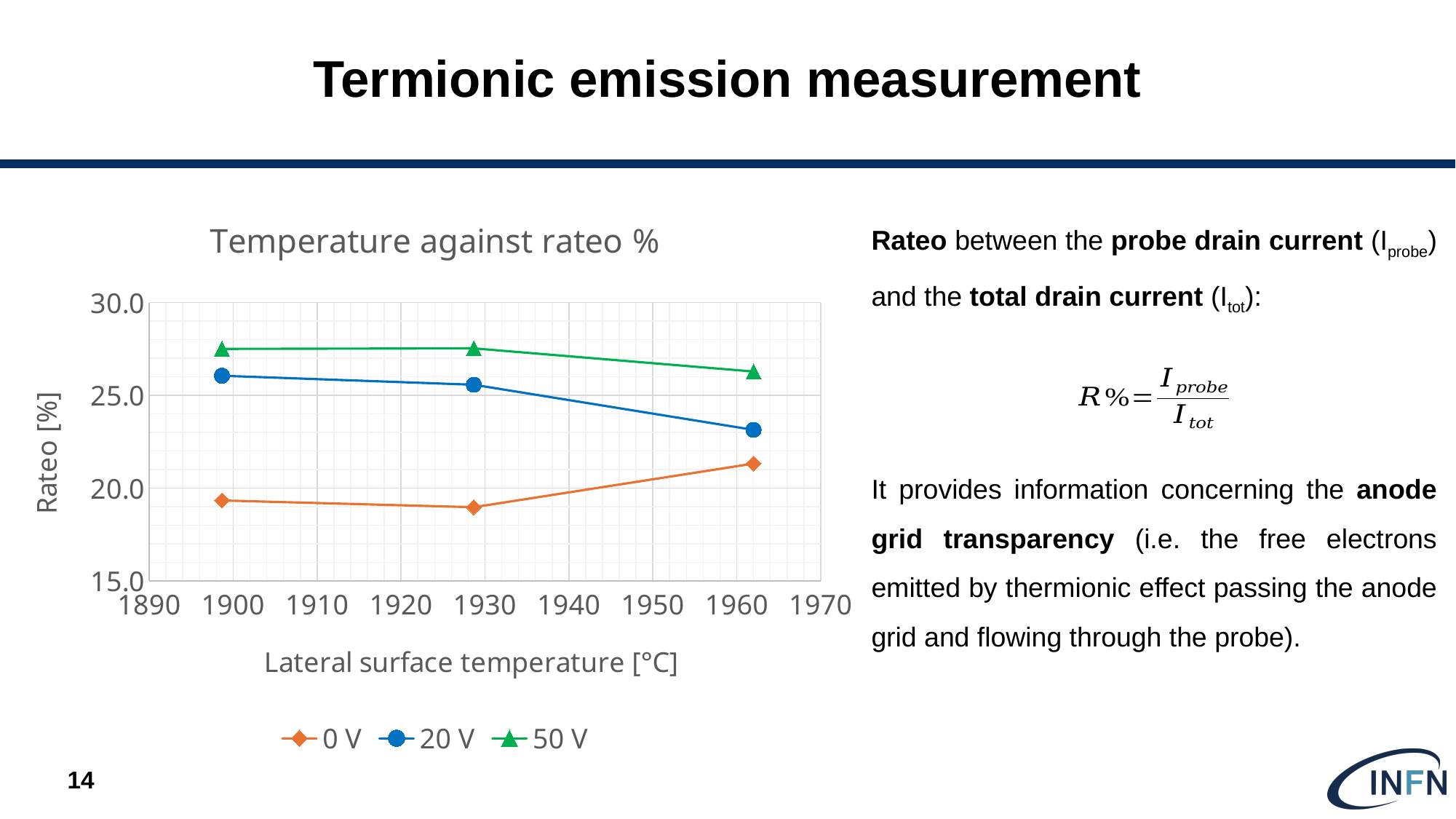
Is the first value of the 50 V series greater or less than 25.0? greater What is the title of the chart? Temperature against rateo % Which series has the highest rateo values across the chart? 50 V Which series has the lowest rateo values across the chart? 0 V How many series does the legend list? 3 Does the 20 V series rise or fall as the lateral surface temperature increases? fall What is the label of the x axis? Lateral surface temperature [°C] Is the first value of the 0 V series greater or less than 20.0? less What kind of chart is shown on the slide? line chart Is the last value of the 20 V series (near 1960) greater or less than 25.0? less At the highest temperature point (near 1960), which series has the larger rateo: 0 V or 50 V? 50 V How many data points does the 20 V series have? 3